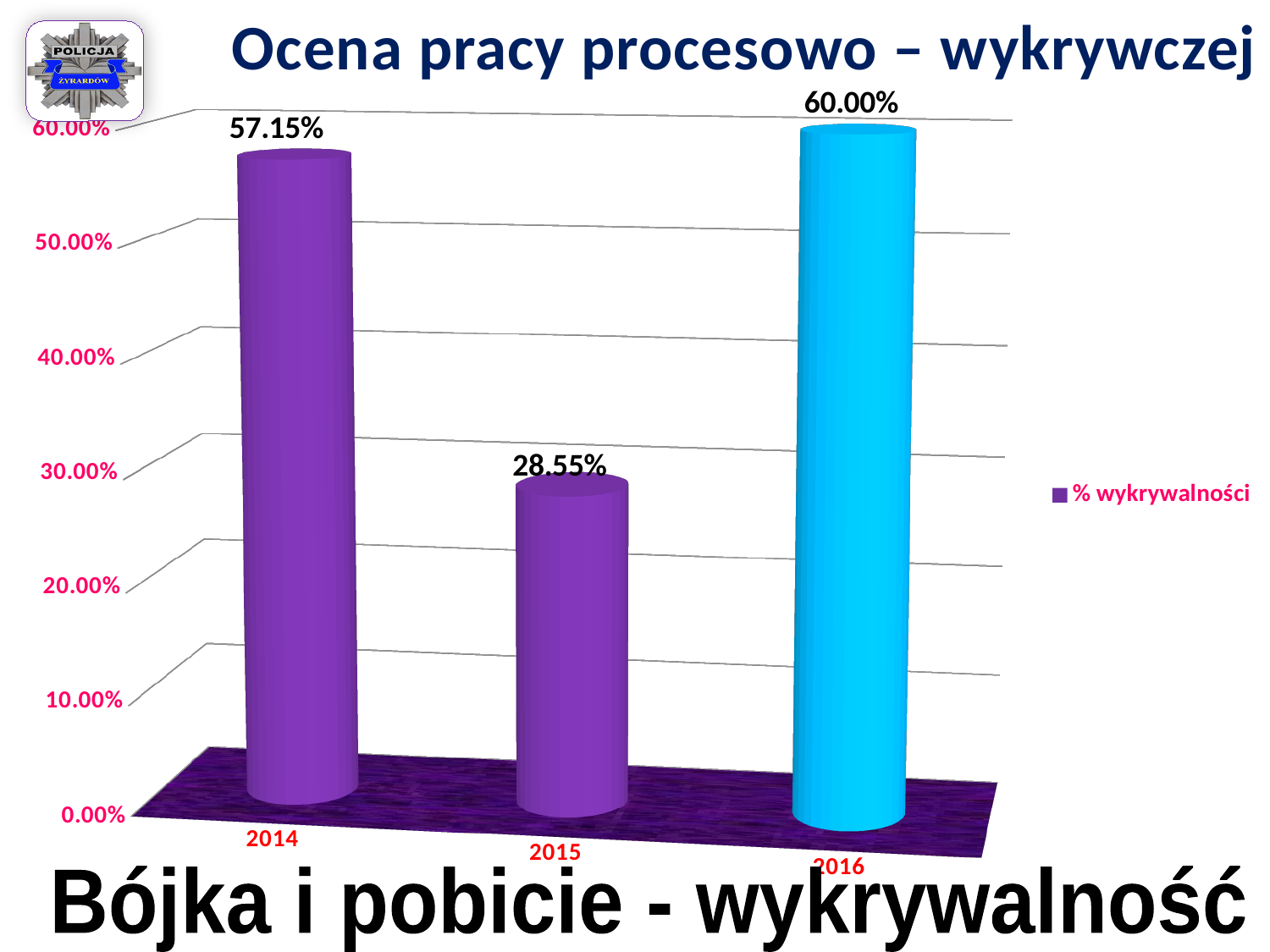
Which year has the lowest detection rate? 2015 What is the detection rate (% wykrywalności) shown for 2016? 60.00% What is the difference between the detection rates for 2014 and 2015? 28.60% Which year has the highest detection rate? 2016 What is the difference between the detection rates for 2016 and 2015? 31.45% Which year has a higher detection rate, 2014 or 2016? 2016 What kind of chart is shown on the slide? bar chart Is the value for 2015 greater or less than 30.00%? less What is the detection rate (% wykrywalności) shown for 2014? 57.15% How many series does the legend list? 1 What is the detection rate (% wykrywalności) shown for 2015? 28.55% How many years are shown on the x axis of the chart? 3